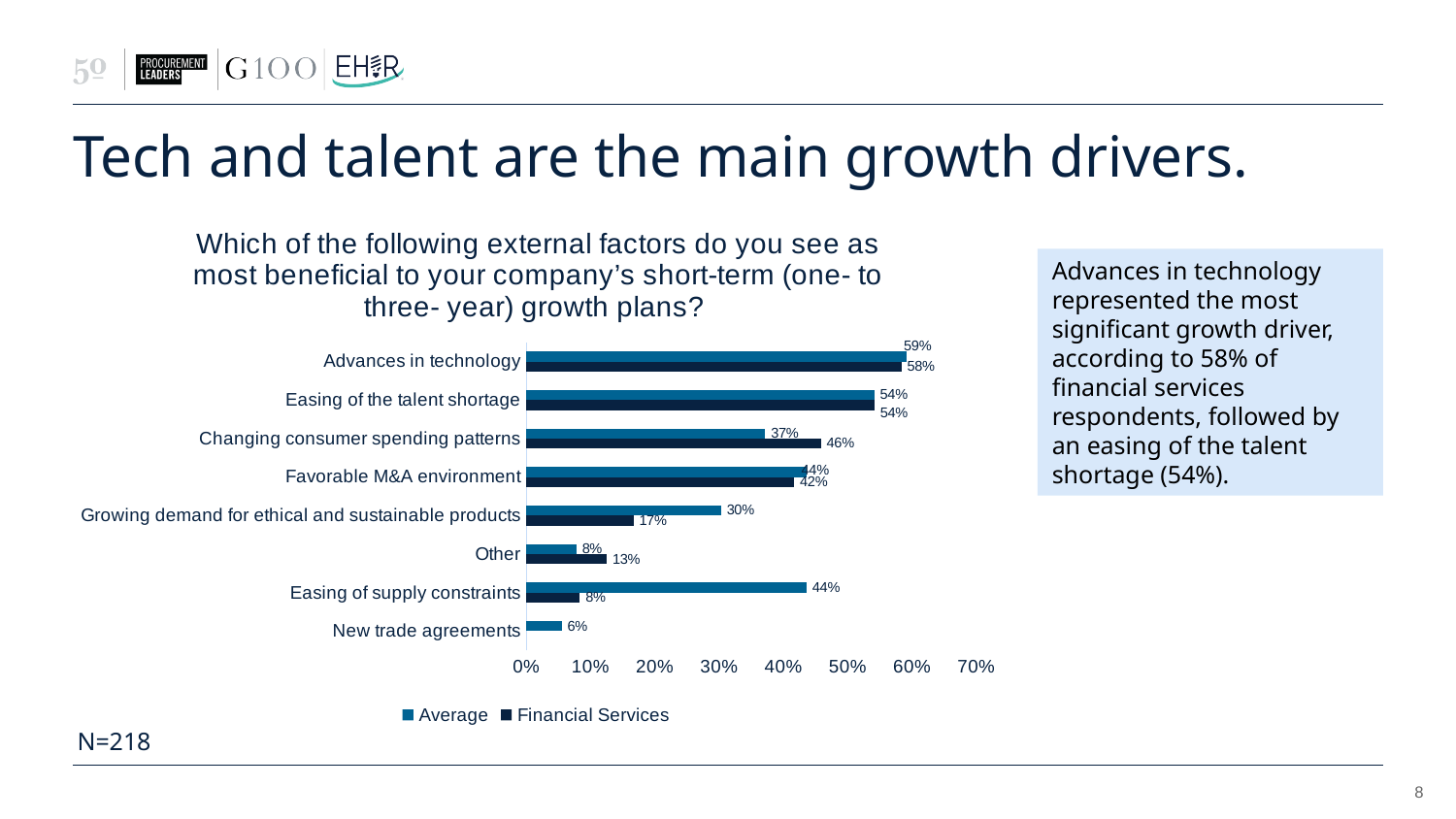
What is the difference between the Average and Financial Services values for Growing demand for ethical and sustainable products? 13 percentage points How many series does the chart legend list? 2 What kind of chart is shown on the slide? Bar chart What is the Financial Services value for Advances in technology? 58% Is the Financial Services value for Easing of supply constraints greater or less than 10%? less What is the Financial Services value for Changing consumer spending patterns? 46% What is the Average value for Easing of supply constraints? 44% What are the two series named in the chart legend? Average and Financial Services Which category has the highest Financial Services value? Advances in technology Which category has the lowest Average value? New trade agreements For the Other category, which is larger: the Average value or the Financial Services value? Financial Services How many external factor categories are plotted on the chart? 8